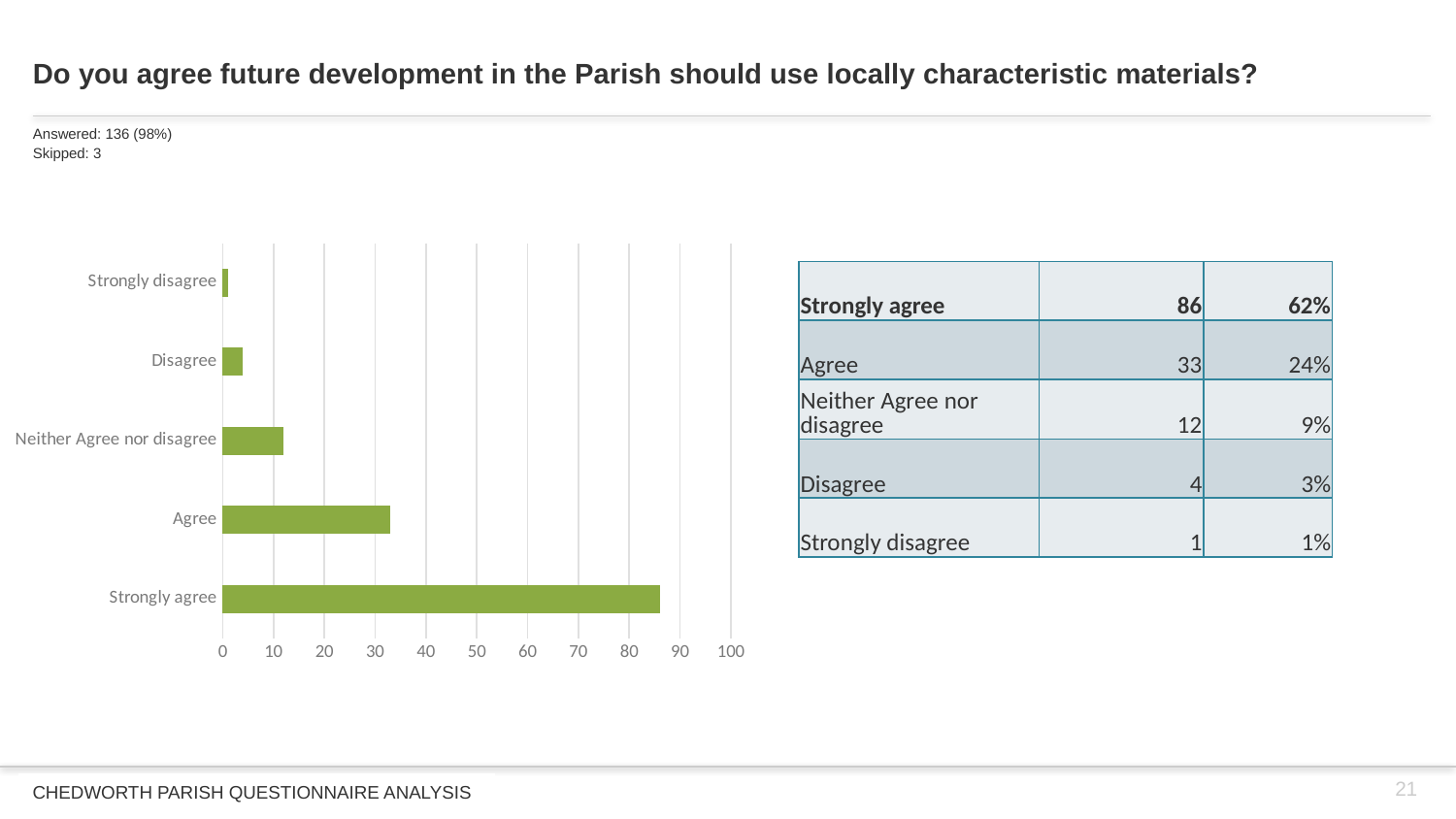
What percentage of respondents chose Disagree? 3% Which is larger, the value for Agree or the value for Neither Agree nor disagree? Agree What is the value for Neither Agree nor disagree? 12 Is the value for Strongly agree greater or less than 80? greater How many categories does the bar chart show? 5 What is the value for Agree? 33 Is the value for Disagree greater or less than 10? less Which category has the highest value in the bar chart? Strongly agree What is the value for Strongly agree? 86 Which category has the lowest value in the bar chart? Strongly disagree What is the difference between the values for Strongly agree and Agree? 53 What kind of chart is shown on the slide? bar chart